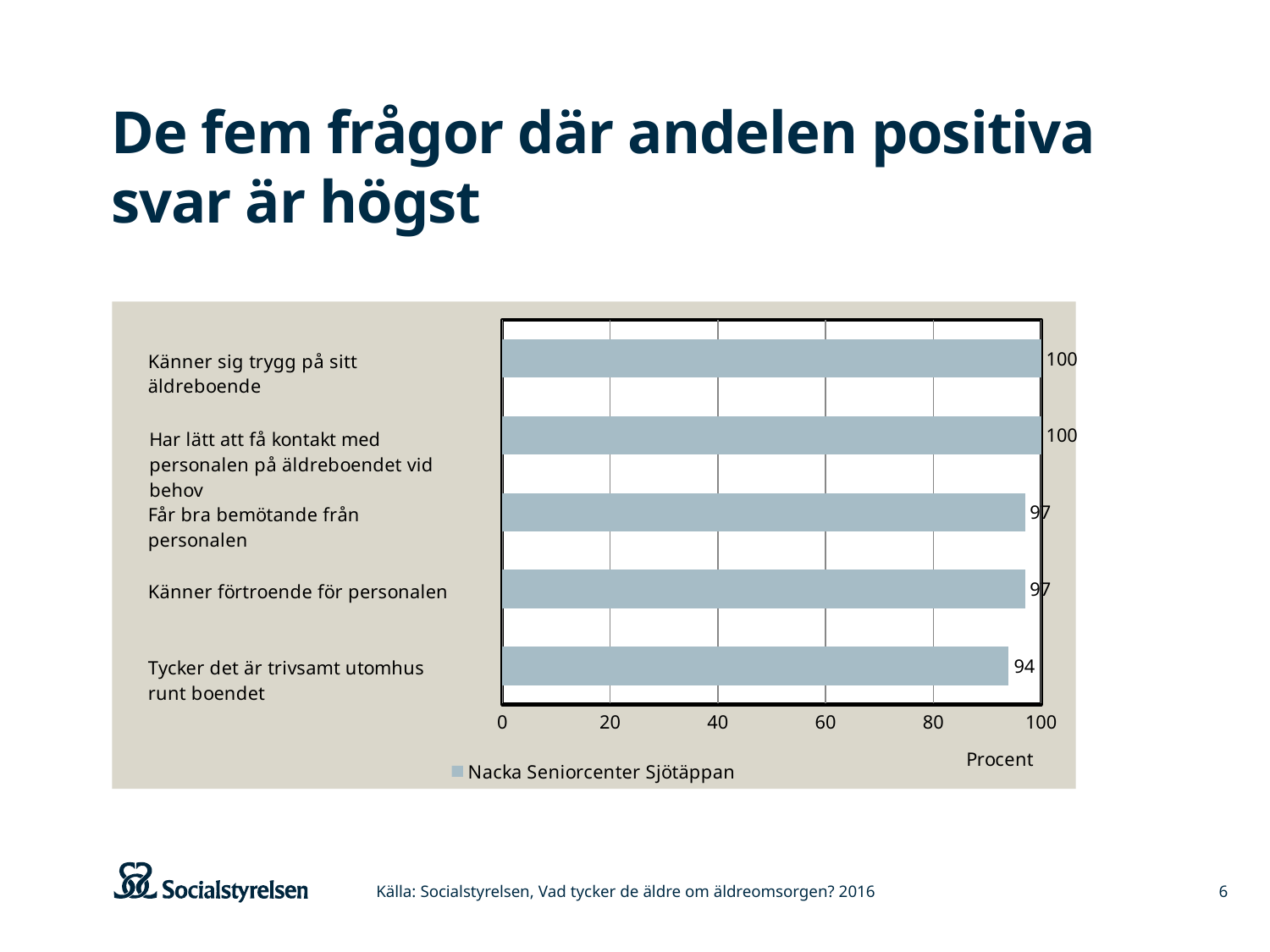
What is the value for "Tycker det är trivsamt utomhus runt boendet"? 94 How many categories are shown in the chart? 5 What is the value for "Får bra bemötande från personalen"? 97 Which is larger: the value for "Känner förtroende för personalen" or the value for "Tycker det är trivsamt utomhus runt boendet"? Känner förtroende för personalen What is the value for "Känner förtroende för personalen"? 97 What series name is shown in the legend? Nacka Seniorcenter Sjötäppan What is the difference between the value for "Har lätt att få kontakt med personalen på äldreboendet vid behov" and the value for "Tycker det är trivsamt utomhus runt boendet"? 6 What is the label of the horizontal axis? Procent Which category has the lowest value? Tycker det är trivsamt utomhus runt boendet What is the value for "Känner sig trygg på sitt äldreboende"? 100 What kind of chart is shown on the slide? Bar chart How many series does the legend list? 1